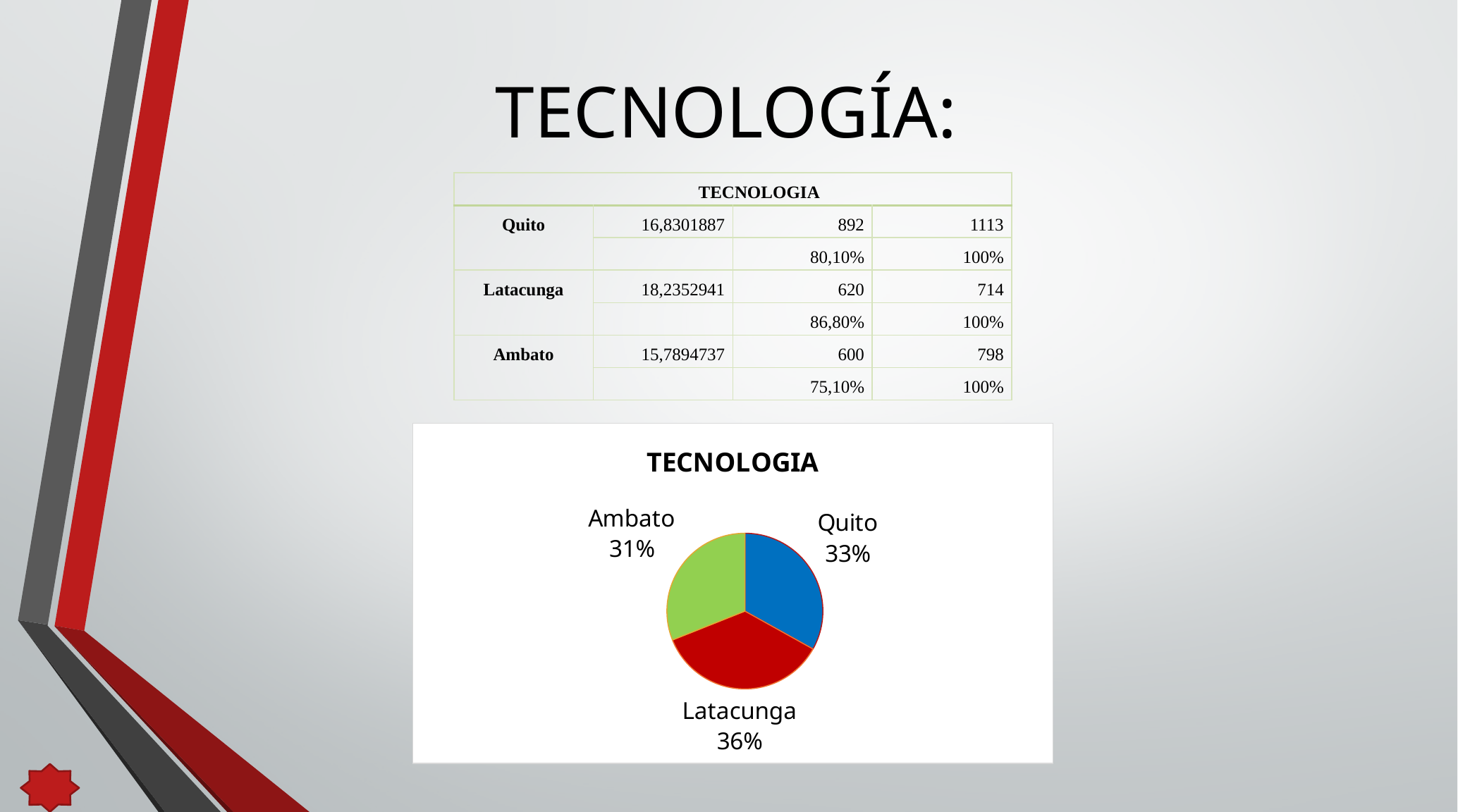
What is the title of the chart? TECNOLOGIA What kind of chart is shown on the slide? pie chart What share of the pie does Latacunga have? 36% What is the difference in percentage points between the Latacunga and Ambato slices? 5 What colour is the Latacunga slice? red What share of the pie does Ambato have? 31% What is the difference in percentage points between the Quito and Ambato slices? 2 How many slices does the pie chart have? 3 Which category has the smallest slice of the pie? Ambato What share of the pie does Quito have? 33% Which slice is larger, Quito or Ambato? Quito Which category has the largest slice of the pie? Latacunga